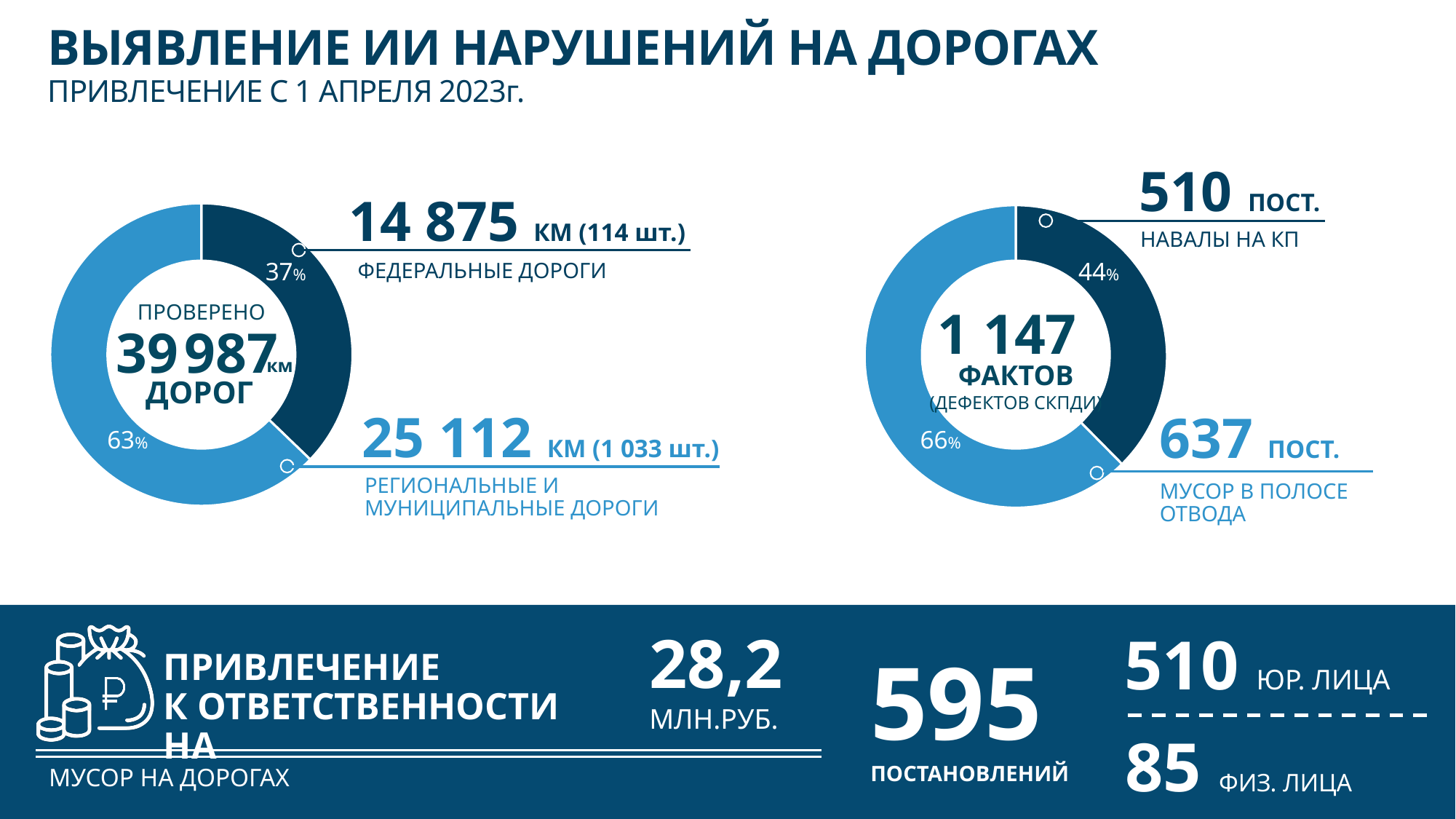
What type of chart is used on the left side of the slide? Donut (pie) chart In the right donut chart, what share is shown for НАВАЛЫ НА КП? 44% In the right donut chart, which category has the larger value: НАВАЛЫ НА КП or МУСОР В ПОЛОСЕ ОТВОДА? МУСОР В ПОЛОСЕ ОТВОДА In the right donut chart (1 147 ФАКТОВ), how many постановлений are shown for НАВАЛЫ НА КП? 510 пост. In the left donut chart, what total number of kilometres of roads is shown in the centre? 39 987 км In the left donut chart, how many kilometres are shown for ФЕДЕРАЛЬНЫЕ ДОРОГИ? 14 875 км In the left donut chart, what share is shown for РЕГИОНАЛЬНЫЕ И МУНИЦИПАЛЬНЫЕ ДОРОГИ? 63% In the left donut chart, how many kilometres are shown for РЕГИОНАЛЬНЫЕ И МУНИЦИПАЛЬНЫЕ ДОРОГИ? 25 112 км In the left donut chart (ПРОВЕРЕНО 39 987 км ДОРОГ), what share is shown for ФЕДЕРАЛЬНЫЕ ДОРОГИ? 37% In the left donut chart, what is the difference in kilometres between РЕГИОНАЛЬНЫЕ И МУНИЦИПАЛЬНЫЕ ДОРОГИ and ФЕДЕРАЛЬНЫЕ ДОРОГИ? 10 237 км In the right donut chart, how many постановлений are shown for МУСОР В ПОЛОСЕ ОТВОДА? 637 пост. In the left donut chart, which category has the larger share: ФЕДЕРАЛЬНЫЕ ДОРОГИ or РЕГИОНАЛЬНЫЕ И МУНИЦИПАЛЬНЫЕ ДОРОГИ? РЕГИОНАЛЬНЫЕ И МУНИЦИПАЛЬНЫЕ ДОРОГИ